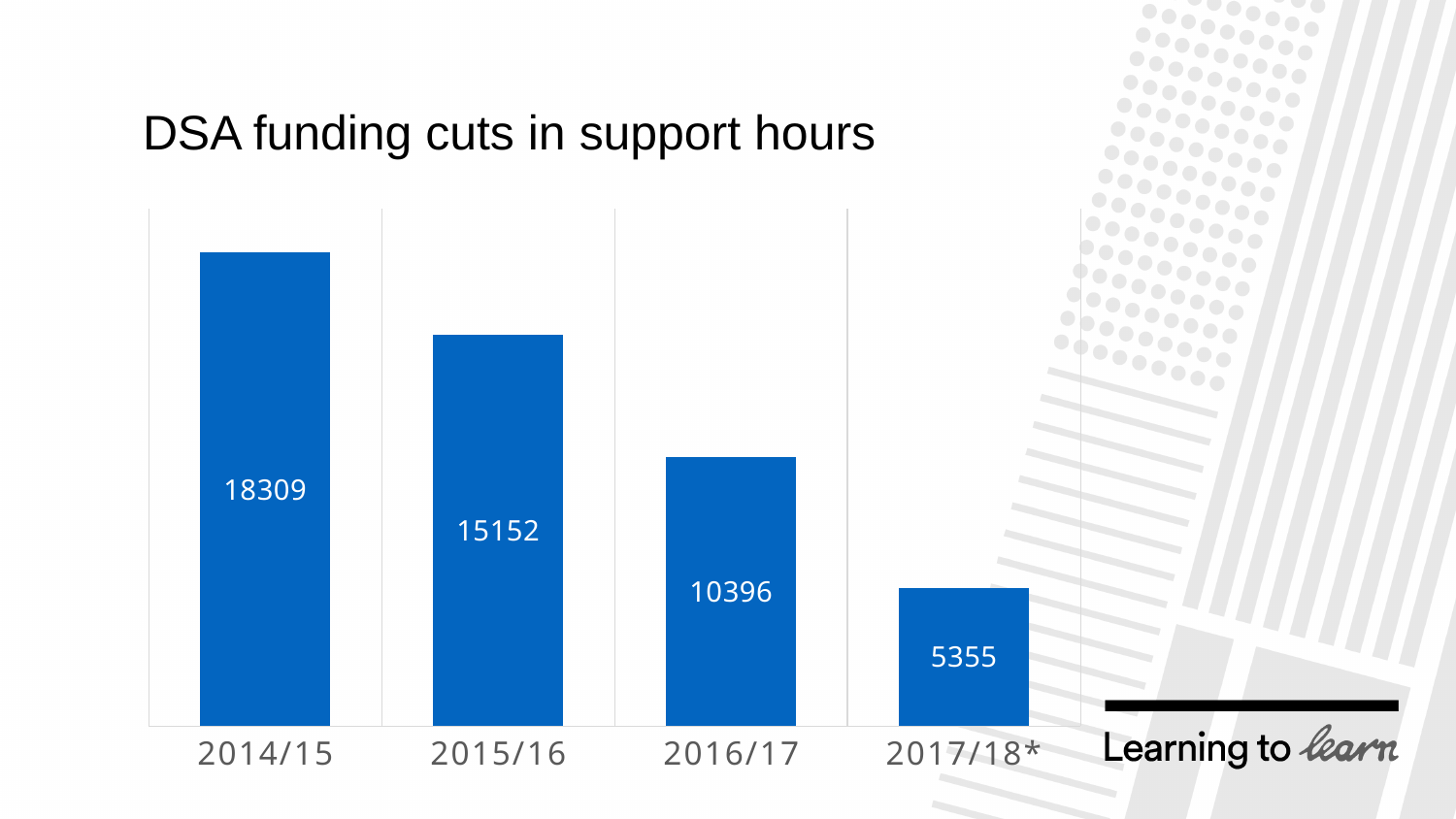
Which year has the lowest value? 2017/18* Which year has the highest value? 2014/15 What is the value for 2017/18*? 5355 What is the value for 2015/16? 15152 What kind of chart is shown on the slide? bar chart Which is larger, the value for 2015/16 or the value for 2016/17? 2015/16 What is the difference between the values for 2014/15 and 2017/18*? 12954 How many years are shown on the chart? 4 What is the difference between the values for 2015/16 and 2016/17? 4756 What is the value for 2014/15? 18309 Do the values rise or fall from 2014/15 to 2017/18*? fall What is the value for 2016/17? 10396